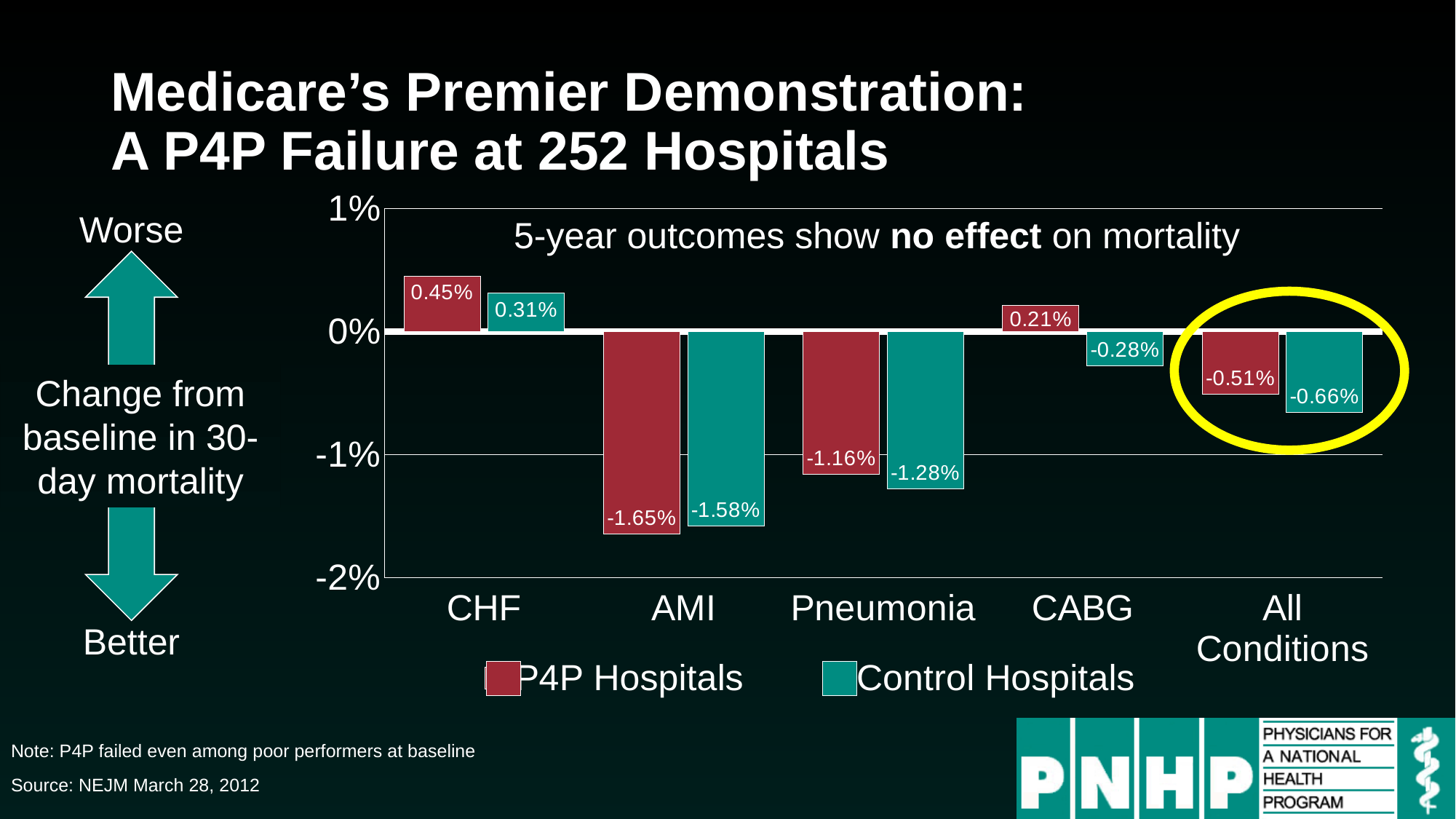
What is the value for P4P Hospitals in the CHF category? 0.45% Which category has the lowest value for P4P Hospitals? AMI What is the value for Control Hospitals in the Pneumonia category? -1.28% What kind of chart is shown on the slide? Bar chart For Pneumonia, which series has the higher value, P4P Hospitals or Control Hospitals? P4P Hospitals Which category has the highest value for Control Hospitals? CHF What is the value for P4P Hospitals in the All Conditions category? -0.51% What is the difference between the P4P Hospitals and Control Hospitals values for All Conditions? 0.15% How many categories are shown on the x axis? 5 How many series does the legend list? 2 What is the value for Control Hospitals in the CABG category? -0.28% What is the difference between the P4P Hospitals and Control Hospitals values for CHF? 0.14%